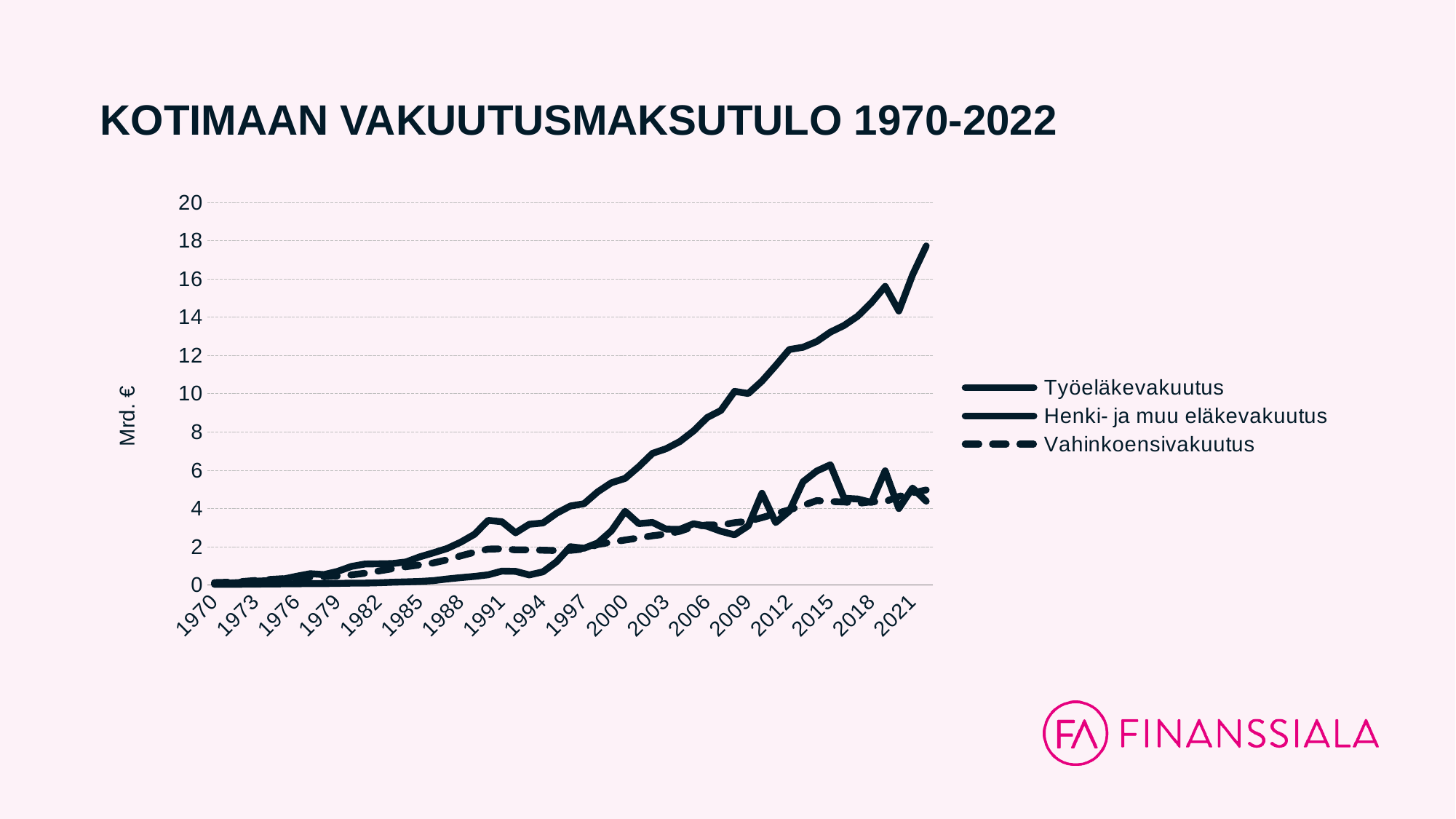
Which series has the lowest value in 1994? Henki- ja muu eläkevakuutus Is the value for Työeläkevakuutus in 2012 greater or less than 10? greater Is the value for Työeläkevakuutus in 2000 greater or less than 8? less Does the Työeläkevakuutus series generally rise or fall from 1970 to 2022? rise Which series has the highest value in 2022? Työeläkevakuutus How many series does the legend list? 3 Is the value for Vahinkoensivakuutus in 2022 greater or less than 4? greater What is the label on the vertical axis? Mrd. € What is the title of the chart? KOTIMAAN VAKUUTUSMAKSUTULO 1970-2022 What kind of chart is shown on the slide? line chart How many year labels are shown on the x axis? 18